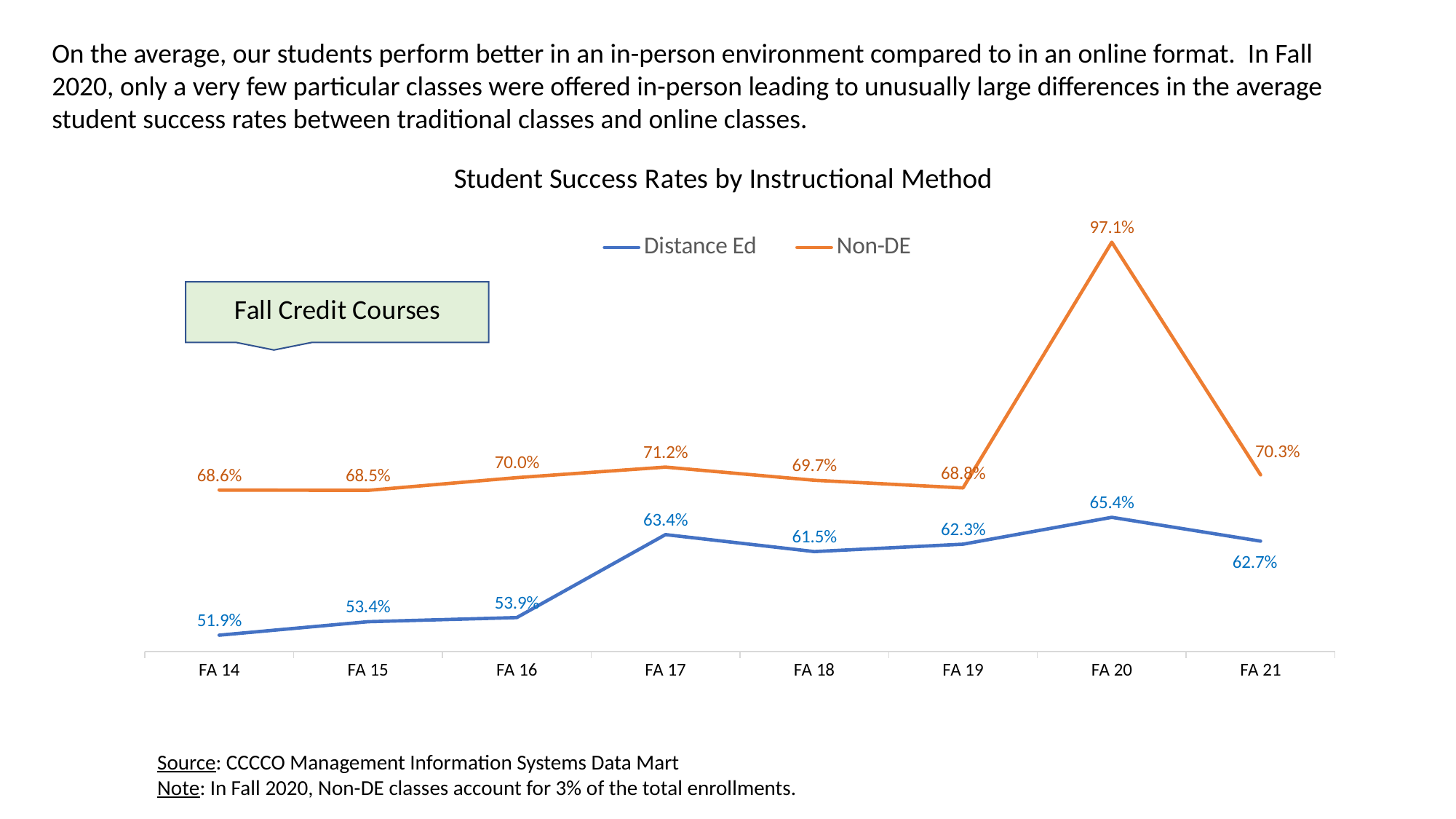
How many terms are shown on the x axis? 8 What kind of chart is shown on the slide? Line chart What is the difference between the Non-DE and Distance Ed success rates in FA 20? 31.7% Which series has the higher success rate in FA 18, Distance Ed or Non-DE? Non-DE How many series does the legend list? 2 What is the title of the chart? Student Success Rates by Instructional Method What is the Non-DE success rate for FA 21? 70.3% What is the Non-DE success rate for FA 20? 97.1% In which term is the Non-DE success rate highest? FA 20 What is the Distance Ed success rate for FA 17? 63.4% In which term is the Distance Ed success rate lowest? FA 14 What is the Distance Ed success rate for FA 14? 51.9%